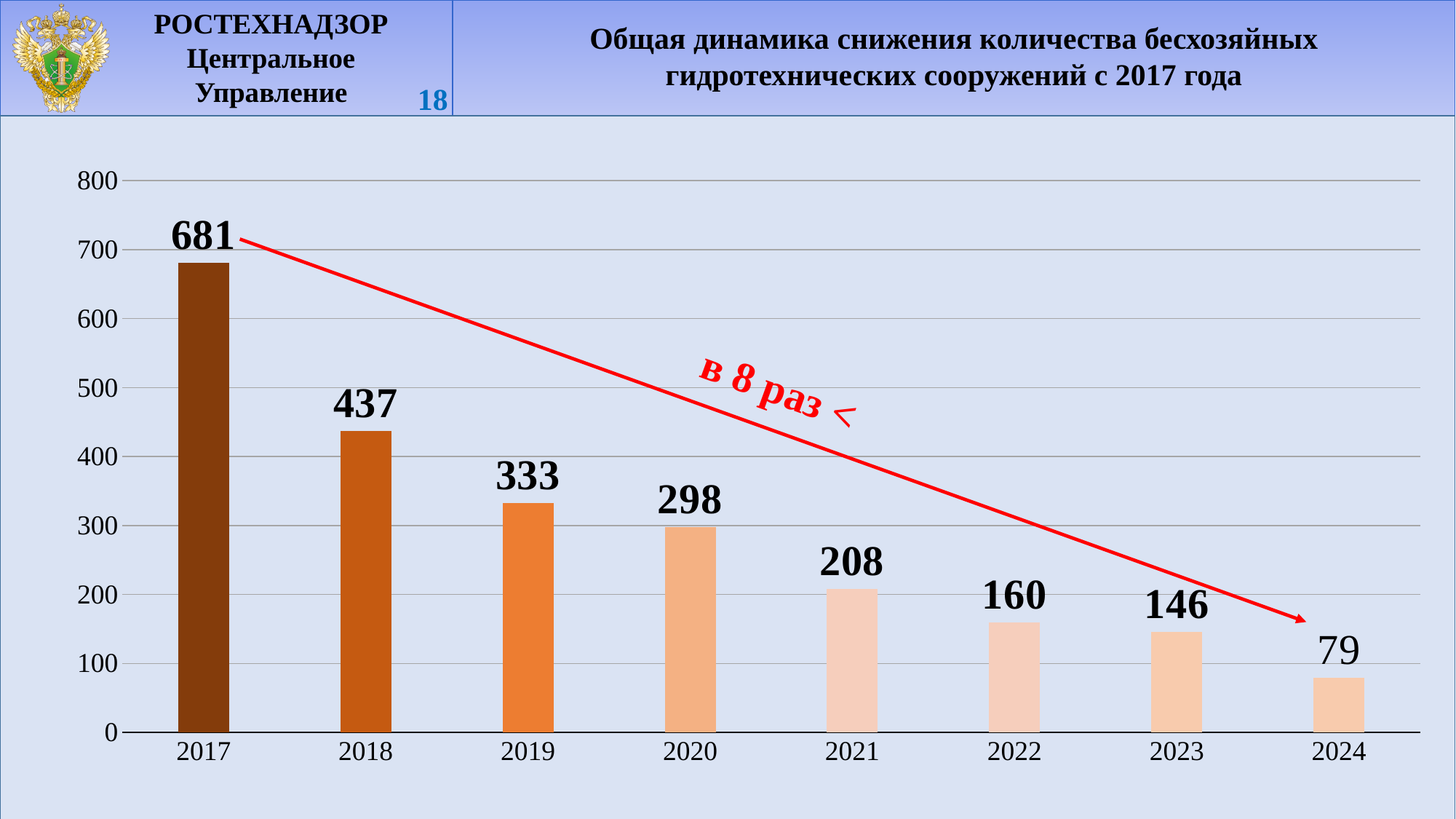
Which is larger, the value for 2019 or the value for 2020? 2019 Is the value for 2018 greater or less than 400? greater How many years are shown on the x axis? 8 What is the value for 2024? 79 What kind of chart is shown on the slide? bar chart Which year has the lowest value? 2024 What is the difference between the values for 2022 and 2023? 14 What is the value for 2021? 208 Which year has the highest value? 2017 What is the difference between the values for 2017 and 2018? 244 What is the value for 2017? 681 Do the values rise or fall from 2017 to 2024? fall